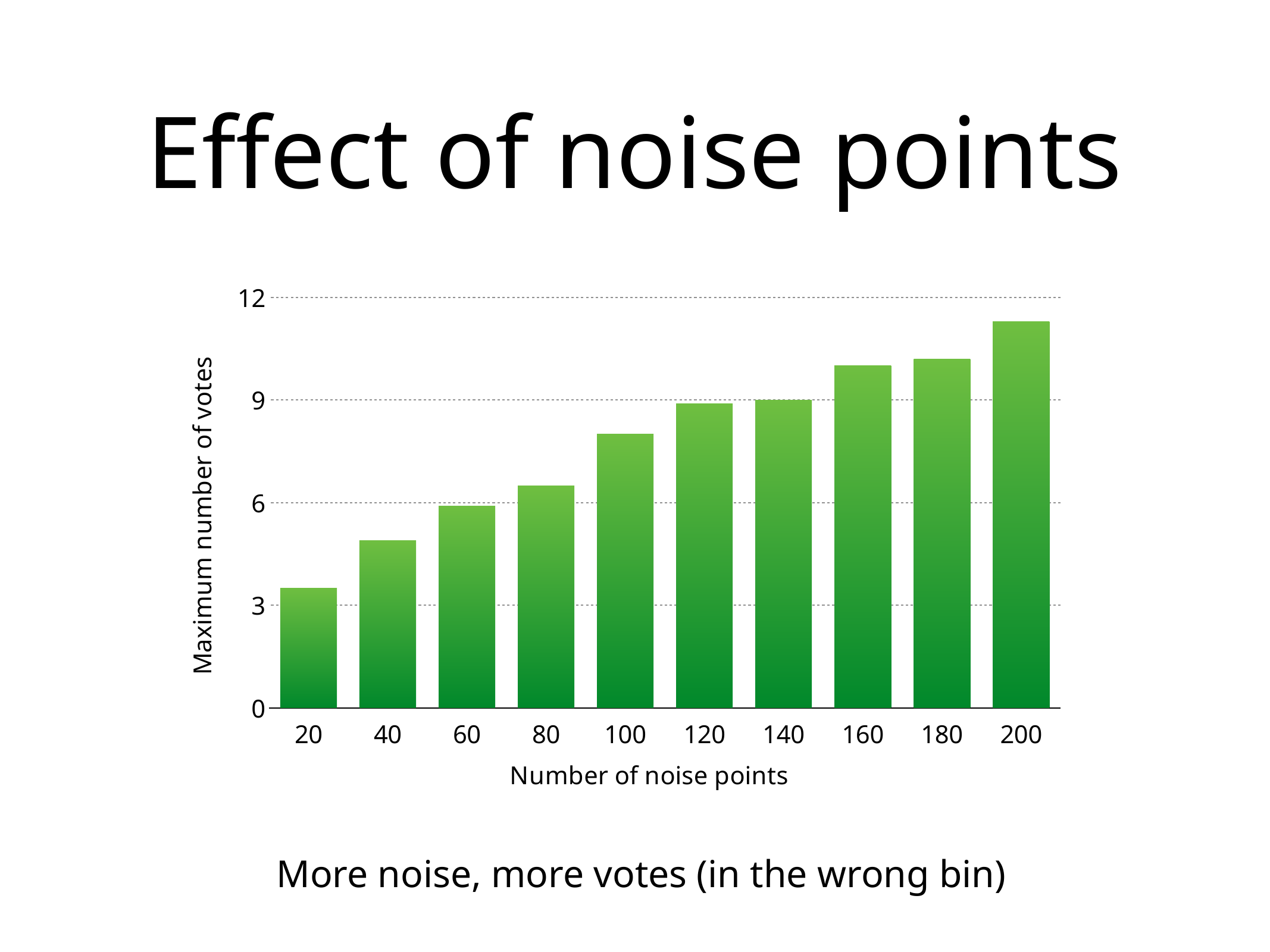
How many bars (categories) are plotted on the chart? 10 Is the value for 80 noise points greater or less than 6? greater Which number of noise points has the highest maximum number of votes? 200 What kind of chart is shown on the slide? bar chart Is the value for 160 noise points greater or less than 9? greater Which has a larger maximum number of votes: 200 noise points or 20 noise points? 200 Do the values rise or fall as the number of noise points increases along the x axis? rise What is the label of the y axis? Maximum number of votes Which number of noise points has the lowest maximum number of votes? 20 Is the value for 100 noise points greater or less than 9? less